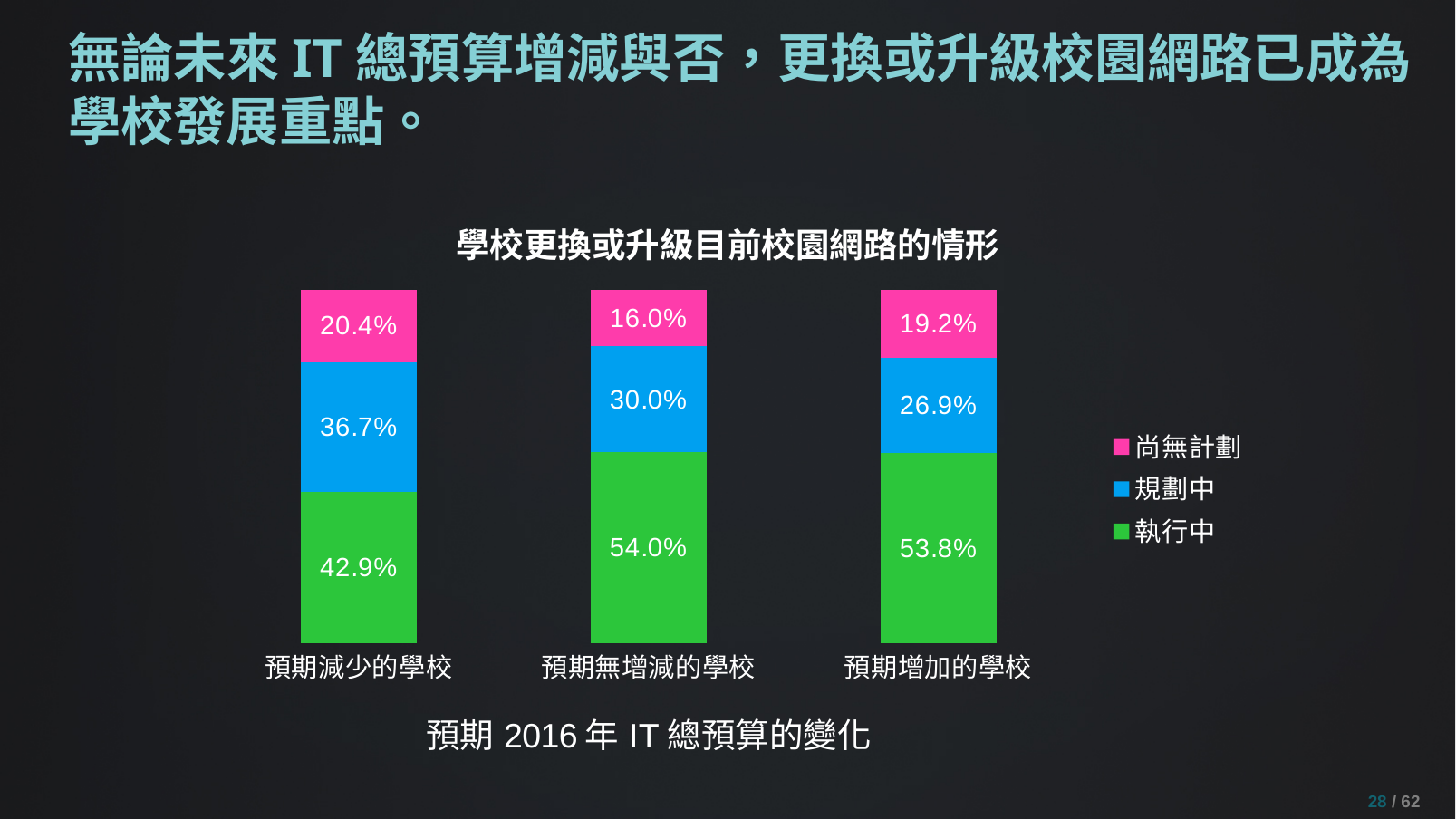
What is the total of the stacked bar for 預期增加的學校? 99.9% What kind of chart is shown on the slide? Stacked bar chart How many series does the legend list? 3 Which category has the highest value for 尚無計劃? 預期減少的學校 What is the value for 執行中 in the 預期無增減的學校 category? 54.0% What is the value for 規劃中 in the 預期減少的學校 category? 36.7% Which category has the lowest value for 執行中? 預期減少的學校 What is the difference between the 規劃中 values for 預期減少的學校 and 預期增加的學校? 9.8% How many categories are shown on the x axis? 3 What is the value for 尚無計劃 in the 預期增加的學校 category? 19.2% Which is larger: the 執行中 value for 預期無增減的學校 or for 預期增加的學校? 預期無增減的學校 What is the title of the chart? 學校更換或升級目前校園網路的情形